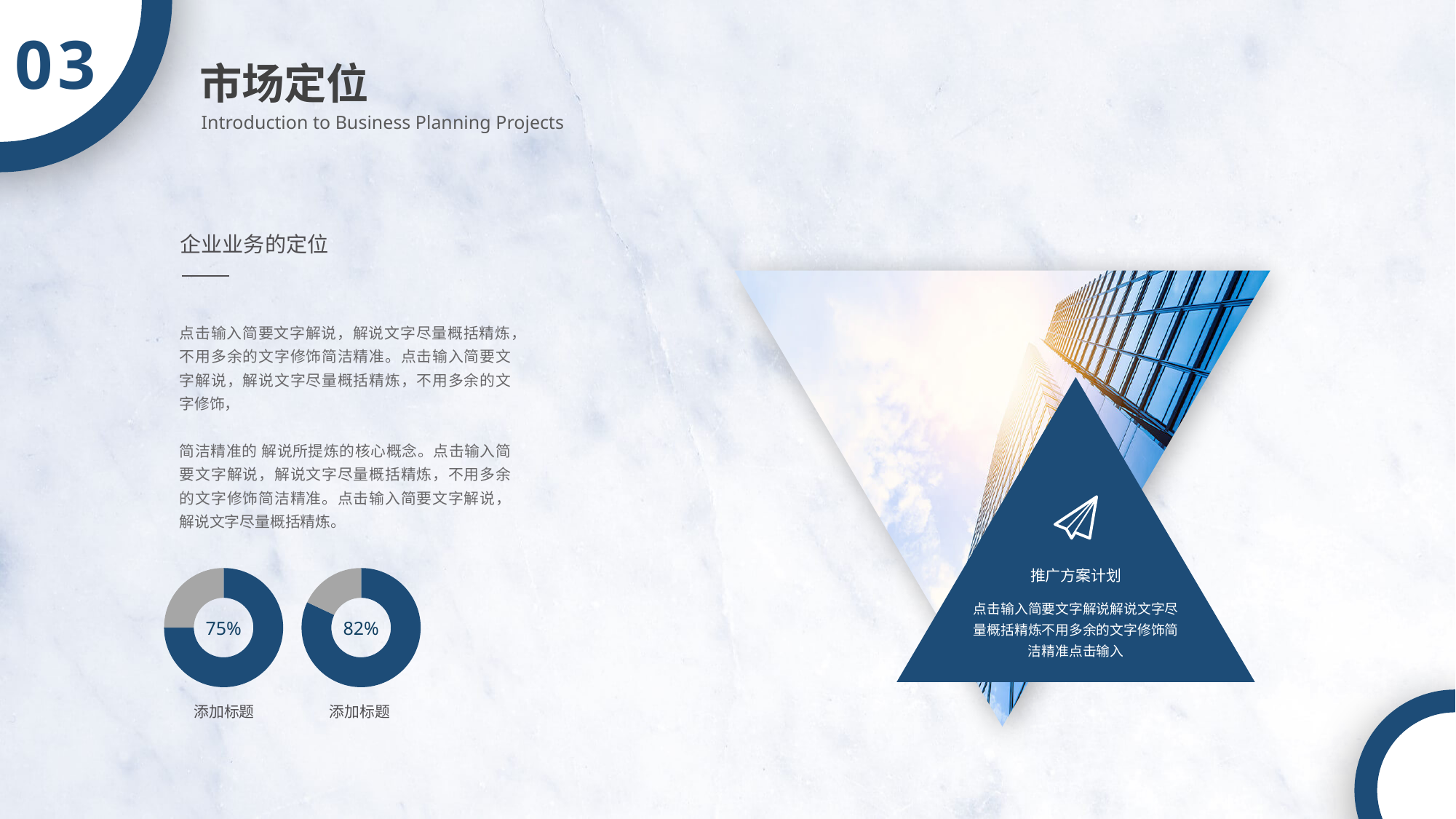
In the left donut chart, what share of the ring is left unfilled (grey)? 25% What value is shown in the centre of the left donut chart? 75% In the right donut chart, what share of the ring is left unfilled (grey)? 18% What label appears below each of the two donut charts? 添加标题 What value is shown in the centre of the right donut chart? 82% Is the value in the right donut chart greater or less than 80%? greater What kind of chart is used to display the 75% and 82% values? donut chart What is the difference between the percentage in the right donut chart and the percentage in the left donut chart? 7% Which donut chart shows the larger percentage, the left one or the right one? the right one Is the value in the left donut chart greater or less than 80%? less How many donut charts are shown on the slide? 2 What colour is the filled portion of the donut charts? dark blue